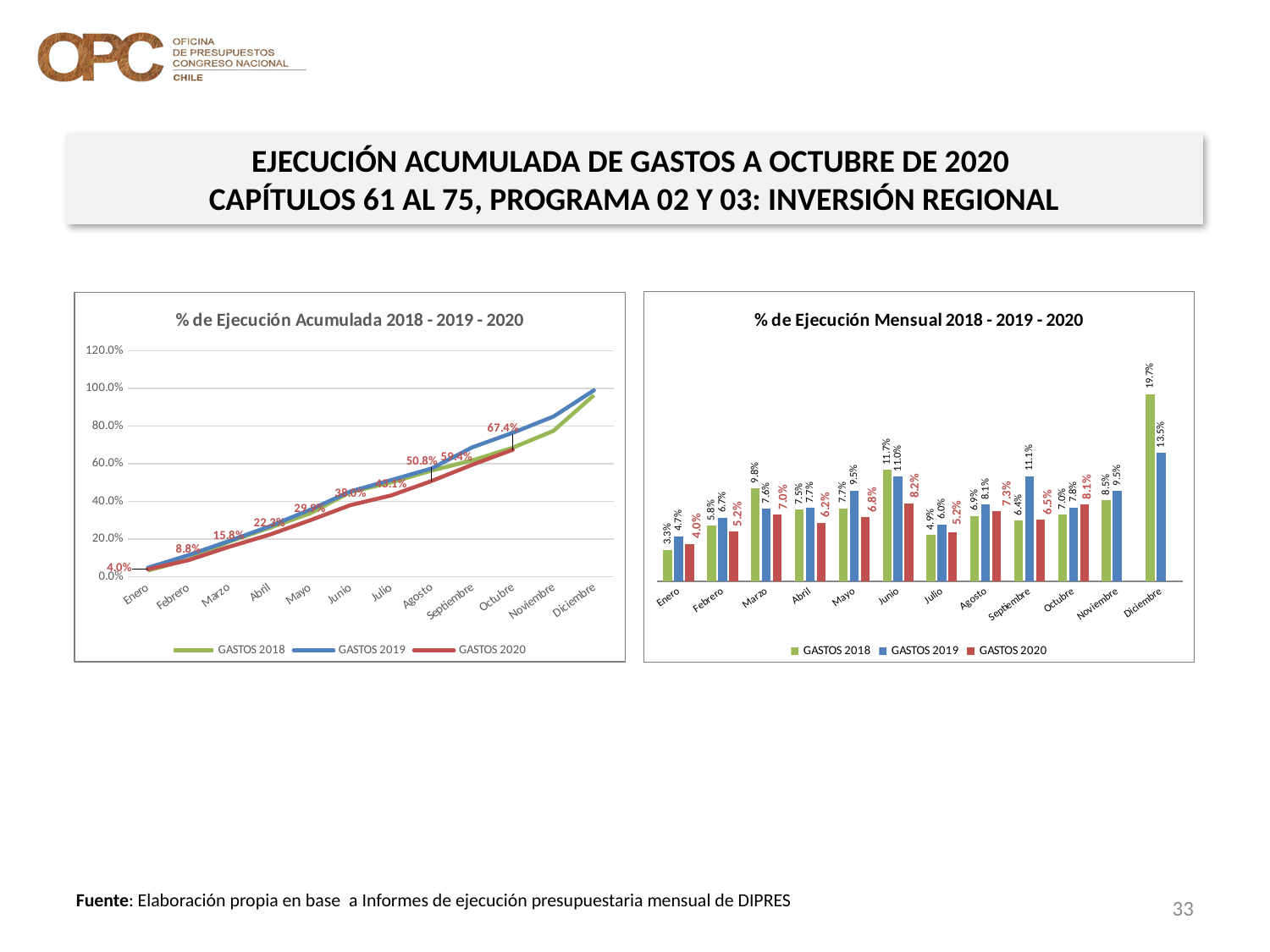
In the '% de Ejecución Acumulada 2018 - 2019 - 2020' chart, is the value for GASTOS 2019 in Diciembre greater or less than 80.0%? greater In the '% de Ejecución Mensual 2018 - 2019 - 2020' chart, which month has the lowest value for GASTOS 2018? Enero In the '% de Ejecución Mensual 2018 - 2019 - 2020' chart, what is the difference between GASTOS 2018 and GASTOS 2019 in Diciembre? 6.2% In the '% de Ejecución Mensual 2018 - 2019 - 2020' chart, what is the value for GASTOS 2019 in Diciembre? 13.5% In the '% de Ejecución Mensual 2018 - 2019 - 2020' chart, which month has the highest value for GASTOS 2018? Diciembre In the '% de Ejecución Acumulada 2018 - 2019 - 2020' chart, what is the value for GASTOS 2020 in Agosto? 50.8% In the '% de Ejecución Mensual 2018 - 2019 - 2020' chart, how many series does the legend list? 3 In the '% de Ejecución Mensual 2018 - 2019 - 2020' chart, what is the value for GASTOS 2020 in Junio? 8.2% What kind of chart is the '% de Ejecución Mensual 2018 - 2019 - 2020' chart? Bar chart In the '% de Ejecución Acumulada 2018 - 2019 - 2020' chart, what is the value for GASTOS 2020 in Octubre? 67.4% In the '% de Ejecución Mensual 2018 - 2019 - 2020' chart, which is larger in Septiembre: GASTOS 2019 or GASTOS 2020? GASTOS 2019 In the '% de Ejecución Acumulada 2018 - 2019 - 2020' chart, do the values for GASTOS 2019 rise or fall from Enero to Diciembre? Rise